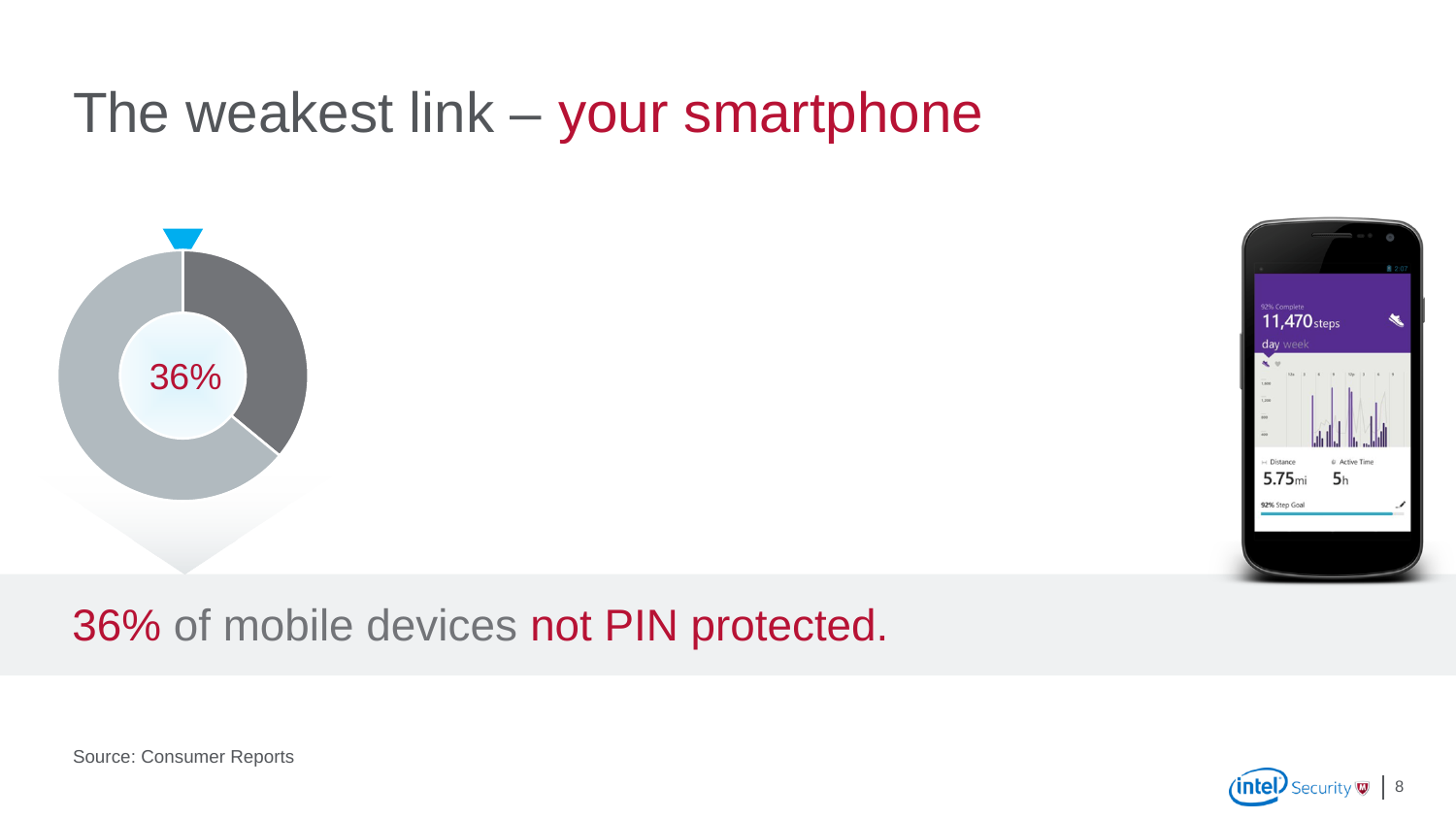
According to the slide, what does the 36% in the donut chart represent? Mobile devices not PIN protected Is the dark grey slice of the donut chart greater or less than 50% of the whole? less What kind of chart is shown on the left of the slide? Pie chart (donut) What share of the donut chart does the dark grey slice represent? 36% What source is cited for the data on the slide? Consumer Reports How many slices does the donut chart have? 2 Which slice of the donut chart is larger, the dark grey slice or the light grey slice? The light grey slice What percentage is printed in the centre of the donut chart? 36% What share of the donut chart does the light grey portion represent? 64%